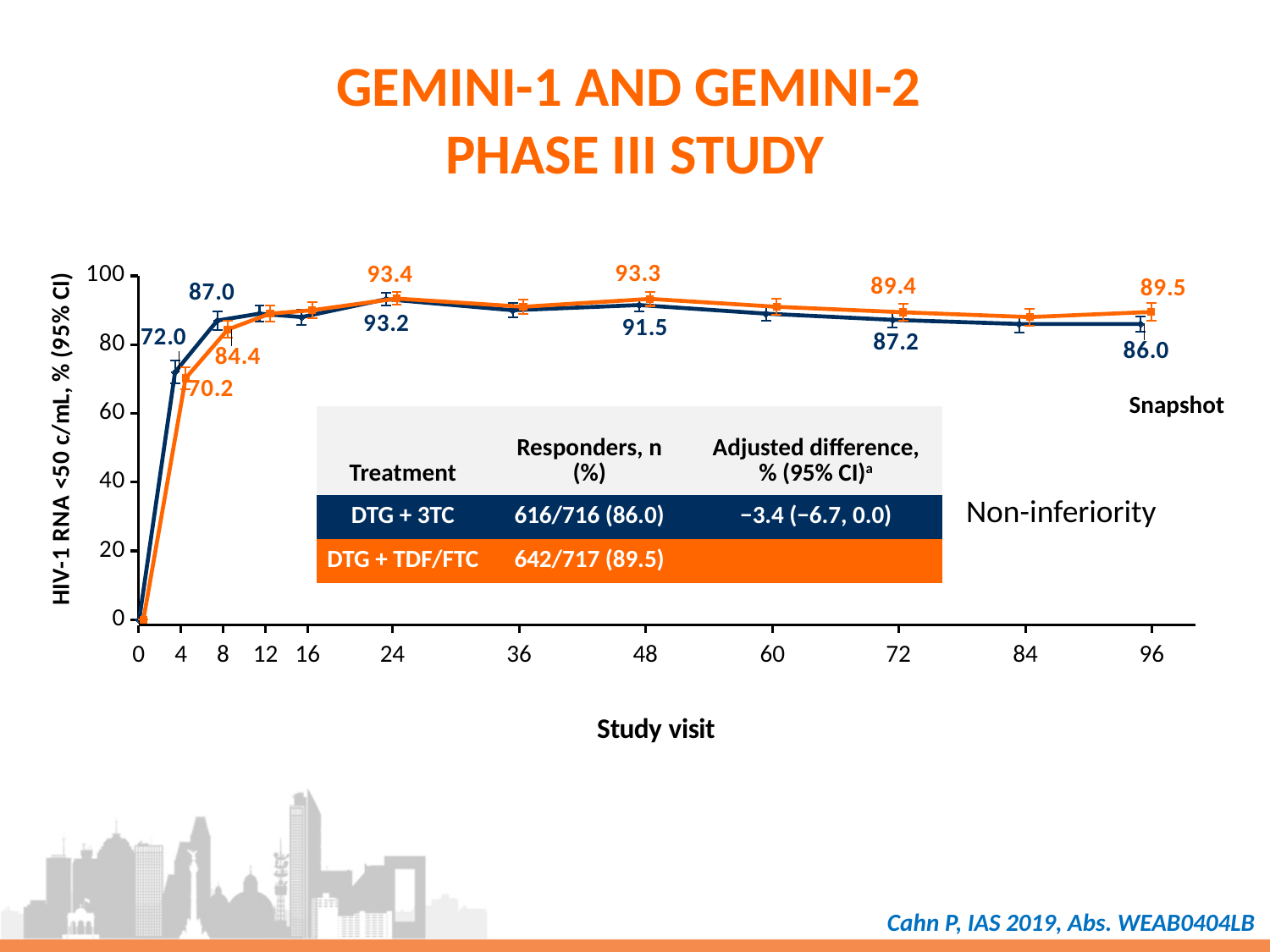
What is the labelled value for DTG + 3TC (navy line) at study visit week 96? 86.0 What is the title of the x axis? Study visit What is the labelled value for DTG + TDF/FTC (orange line) at week 48? 93.3 What kind of chart is shown on the slide? line chart How many study visit tick labels are shown on the x axis? 12 What is the labelled value for DTG + 3TC (navy line) at week 24? 93.2 At week 96, what is the difference between the DTG + TDF/FTC value (89.5) and the DTG + 3TC value (86.0)? 3.5 Is the value for DTG + 3TC (navy line) at week 36 greater or less than 80? greater What is the labelled value for DTG + TDF/FTC (orange line) at study visit week 96? 89.5 At which study visit does the DTG + 3TC (navy) line reach its highest labelled value? Week 24 (93.2) What is the lowest labelled value shown for the DTG + TDF/FTC (orange) line? 70.2 At week 8, which treatment has the higher labelled value: DTG + 3TC (87.0) or DTG + TDF/FTC (84.4)? DTG + 3TC